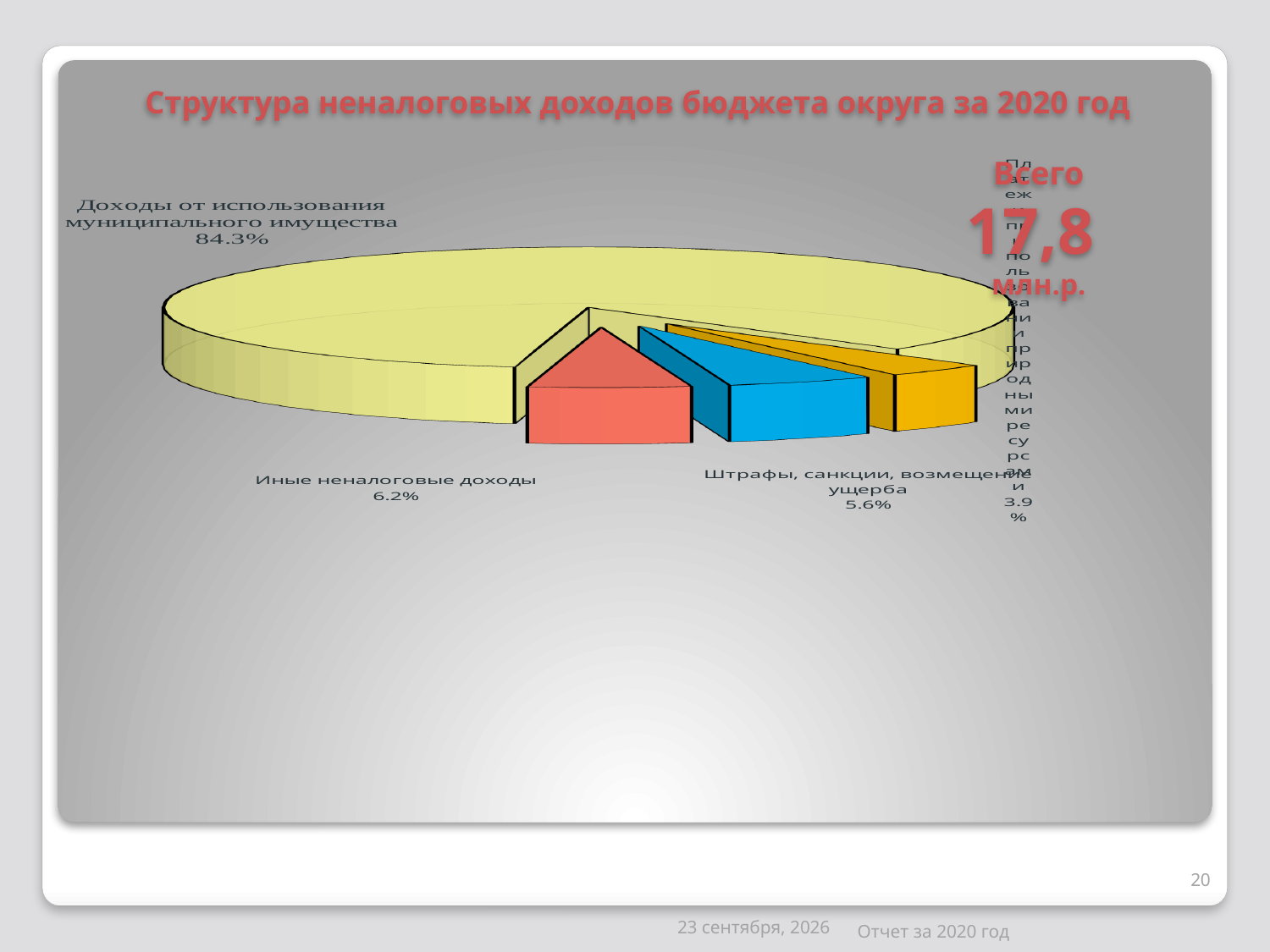
Which is larger: 'Иные неналоговые доходы' or 'Штрафы, санкции, возмещение ущерба'? Иные неналоговые доходы How many slices does the pie chart have? 4 What is the difference between the shares of 'Иные неналоговые доходы' and 'Штрафы, санкции, возмещение ущерба'? 0.6 percentage points What share is shown for 'Штрафы, санкции, возмещение ущерба'? 5.6% What kind of chart is shown on the slide? pie chart What total amount is stated on the slide next to the chart? 17,8 млн.р. Which category has the largest slice of the pie? Доходы от использования муниципального имущества What is the title of the chart? Структура неналоговых доходов бюджета округа за 2020 год What share of the pie is labelled for 'Доходы от использования муниципального имущества'? 84.3% By how many percentage points does 'Доходы от использования муниципального имущества' exceed 'Иные неналоговые доходы'? 78.1 percentage points What share is shown for 'Иные неналоговые доходы'? 6.2% What colour is the slice for 'Иные неналоговые доходы'? red